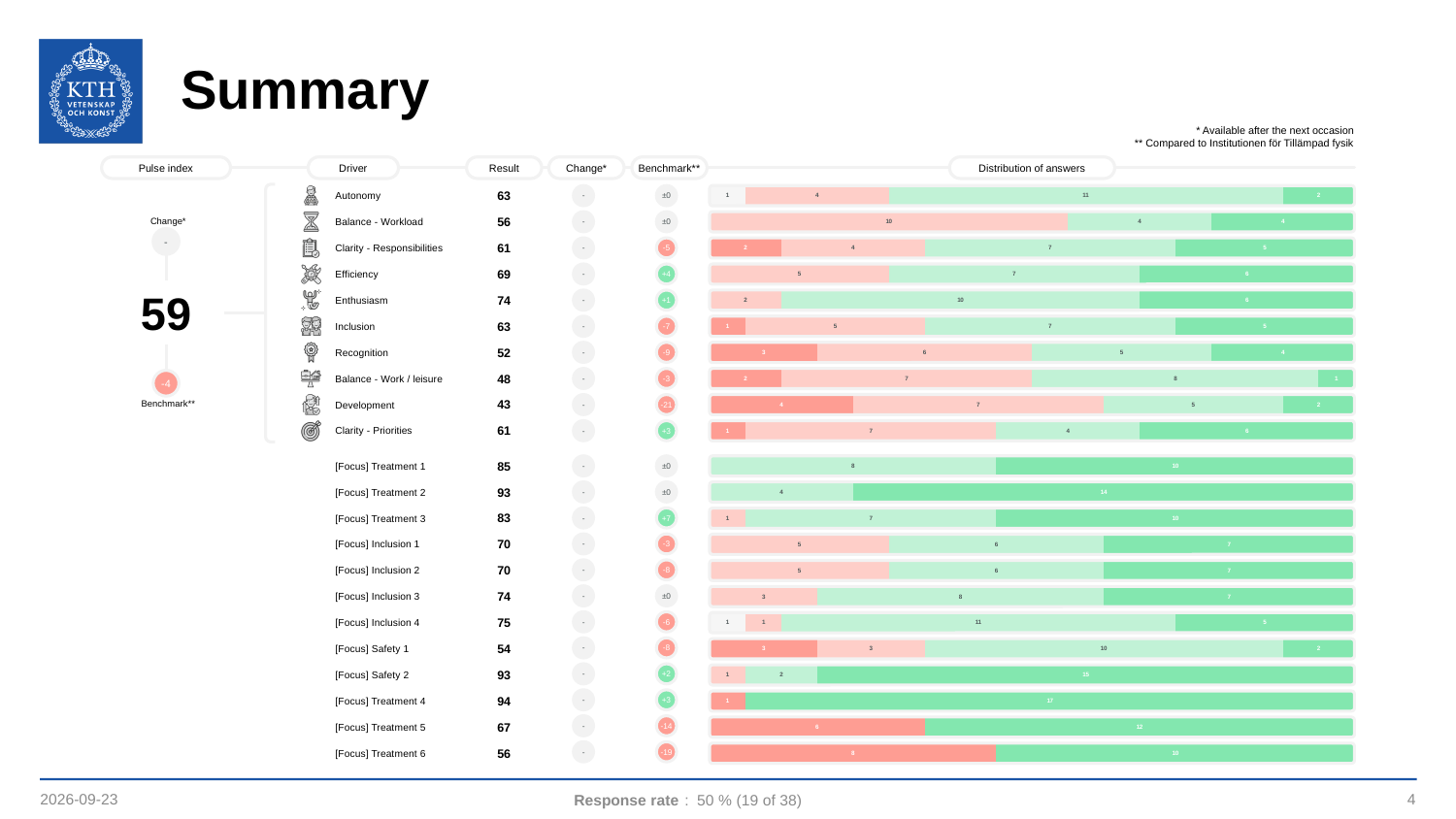
Which driver in the top group (Autonomy through Clarity - Priorities) has the lowest Result? Development Which [Focus] item has the highest Result? [Focus] Treatment 4 In the Distribution of answers for [Focus] Treatment 4, how many answers are in the dark green segment? 17 What is the Result value for Enthusiasm? 74 What is the Result value for Development? 43 What is the Benchmark value for Development? -21 Which has a higher Result, Recognition or Inclusion? Inclusion Which driver in the top group (Autonomy through Clarity - Priorities) has the highest Result? Enthusiasm What is the difference between the Result for [Focus] Treatment 2 and [Focus] Treatment 6? 37 How many [Focus] items are listed in the table? 12 What kind of chart is used in the Distribution of answers column? Stacked bar chart What is the Pulse index shown on the left of the slide? 59